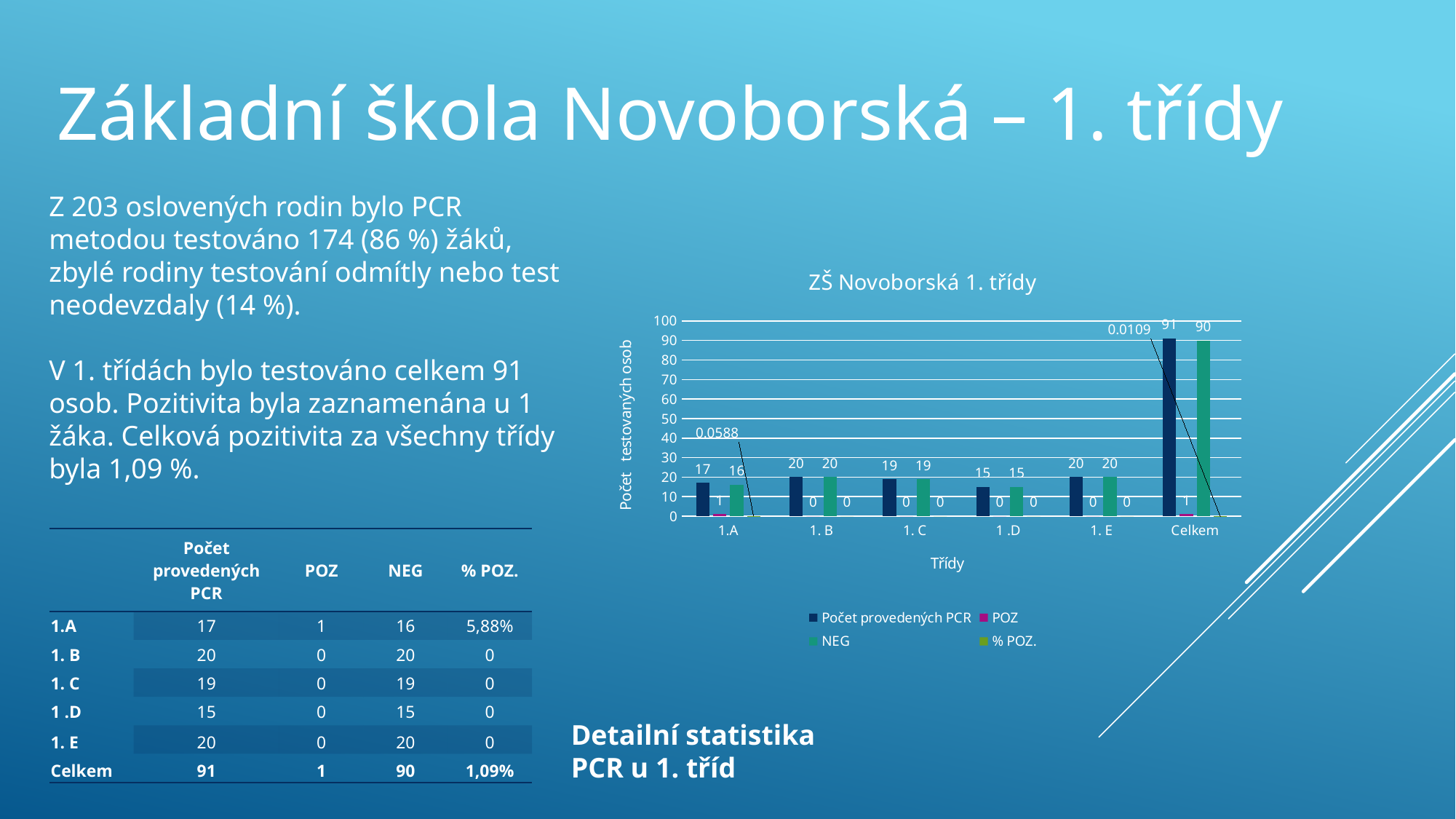
Is the Počet provedených PCR value for Celkem greater or less than 50? greater What type of chart is shown on the slide? bar chart What is the NEG value for Celkem in the chart? 90 What is the % POZ. data label shown for 1.A in the chart? 0.0588 What is the value of Počet provedených PCR for 1. C in the chart? 19 Which is larger in the chart: the NEG value for 1.A or the NEG value for 1. C? 1. C Which class (excluding Celkem) has the lowest Počet provedených PCR in the chart? 1 .D What is the difference between the Počet provedených PCR values for 1. B and 1 .D in the chart? 5 How many series does the chart legend list? 4 How many categories are shown on the x axis of the chart? 6 What is the POZ value for 1. E in the chart? 0 What is the title of the chart? ZŠ Novoborská 1. třídy